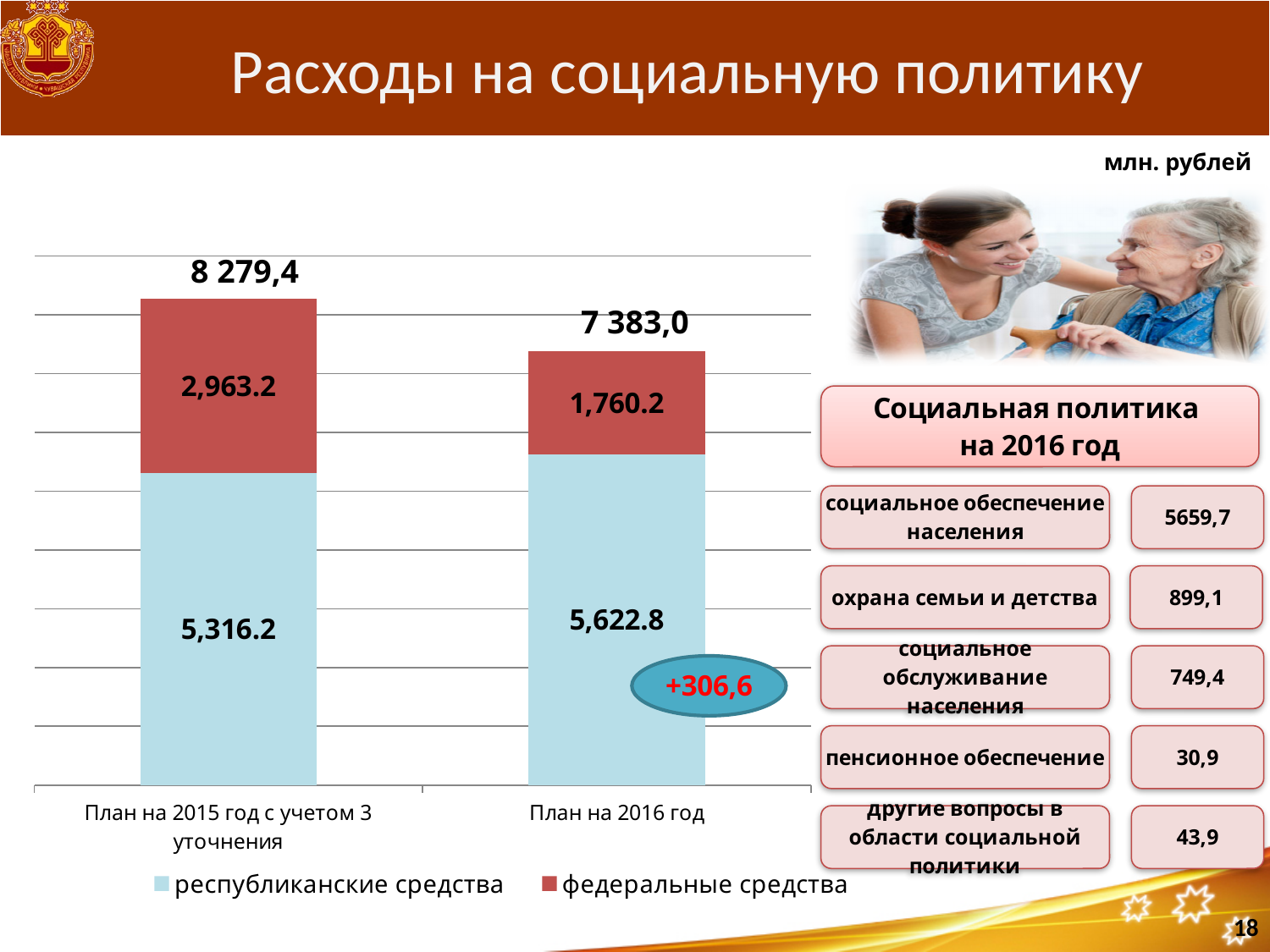
Which category has the higher value for республиканские средства? План на 2016 год What is the total of the stacked bar for План на 2016 год? 7 383,0 What is the difference between республиканские средства for План на 2016 год and for План на 2015 год с учетом 3 уточнения? 306.6 How many series does the legend list? 2 What kind of chart is shown on the slide? Stacked bar chart What is the value of республиканские средства for План на 2016 год? 5,622.8 What is the value of республиканские средства for План на 2015 год с учетом 3 уточнения? 5,316.2 How many categories are shown on the x axis? 2 What is the value of федеральные средства for План на 2016 год? 1,760.2 What is the value of федеральные средства for План на 2015 год с учетом 3 уточнения? 2,963.2 What is the total of the stacked bar for План на 2015 год с учетом 3 уточнения? 8 279,4 Which category has the higher value for федеральные средства, План на 2015 год с учетом 3 уточнения or План на 2016 год? План на 2015 год с учетом 3 уточнения